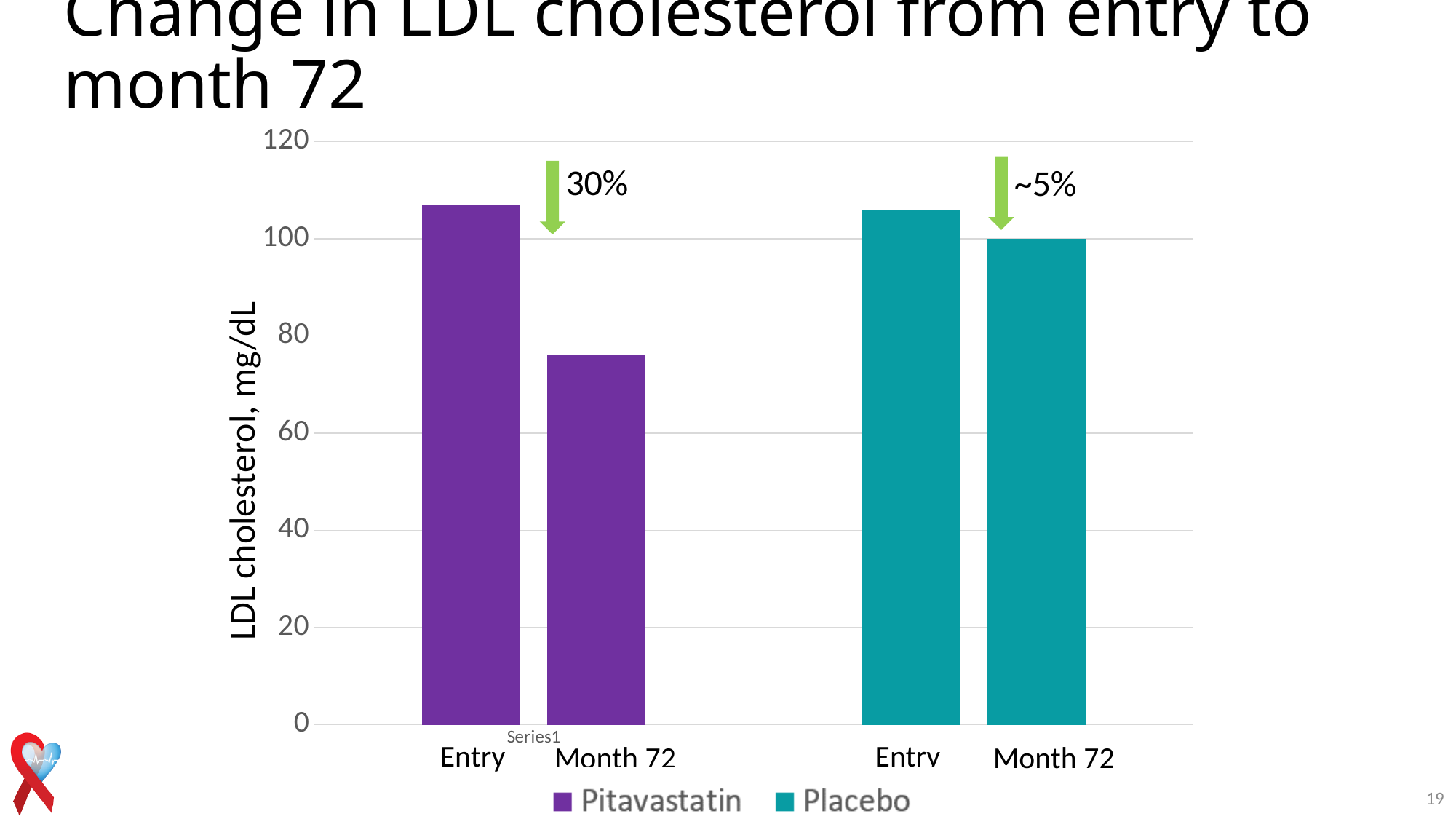
Is the Pitavastatin Month 72 value greater or less than 80? less Which bar has the lowest LDL cholesterol value? Pitavastatin Month 72 Is the Placebo Entry value greater or less than 100? greater Which is larger at Month 72: the Pitavastatin value or the Placebo value? Placebo What is the label on the y axis? LDL cholesterol, mg/dL What is the Placebo LDL cholesterol value at Month 72, in mg/dL? 100 How many bars are plotted in the chart? 4 What percentage decrease is annotated for the Pitavastatin group? 30% Does the Pitavastatin LDL cholesterol rise or fall from Entry to Month 72? fall How many series does the legend list? 2 What kind of chart is shown on the slide? bar chart Is the Pitavastatin Entry value greater or less than 100? greater